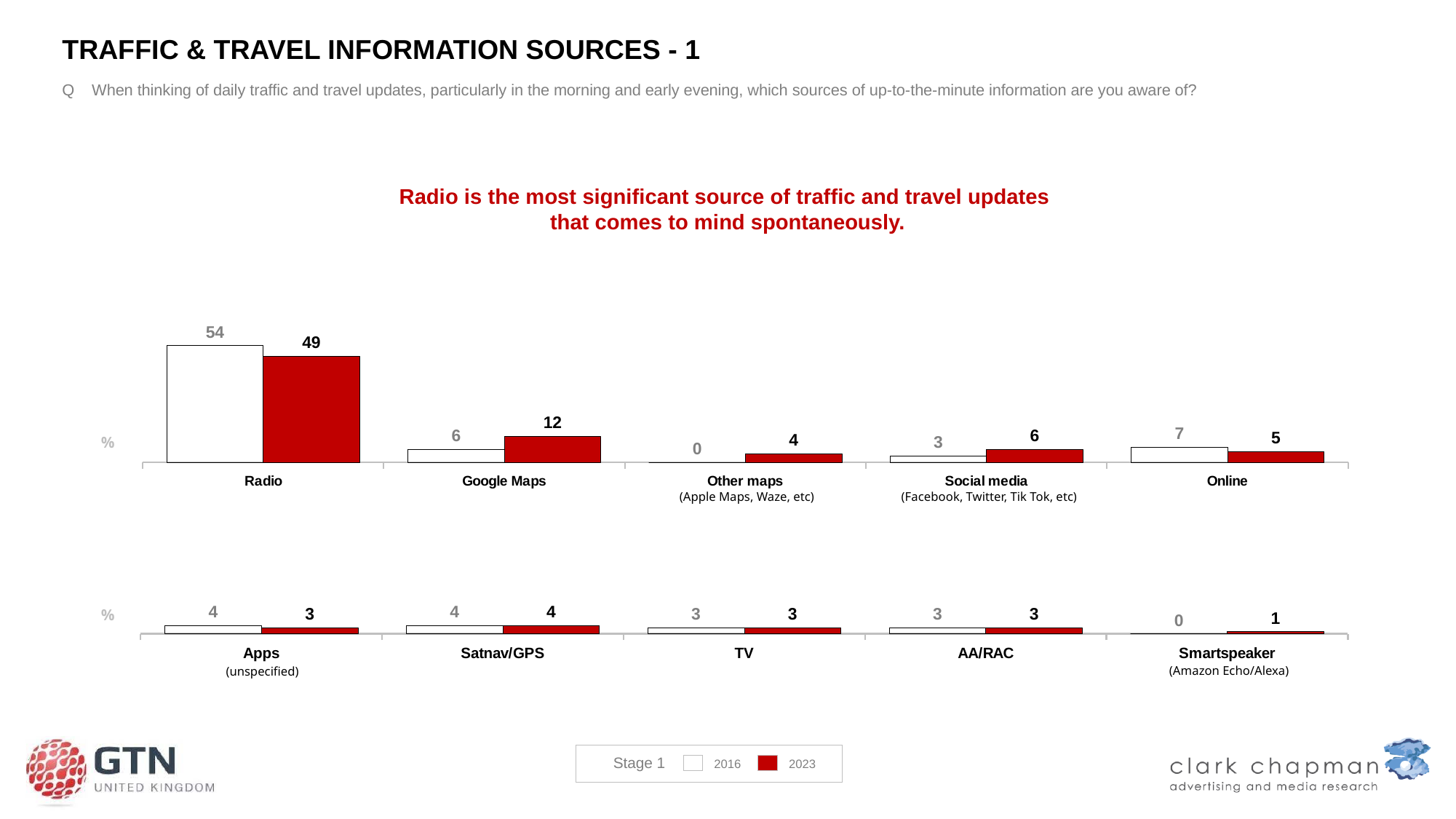
How many categories are shown in the bottom chart? 5 In the bottom chart, what is the 2016 value for Apps? 4 How many series does the legend list? 2 In the top chart, what is the difference between the 2016 and 2023 values for Radio? 5 In the top chart, what is the 2016 value for Google Maps? 6 In the bottom chart, what is the 2023 value for Smartspeaker? 1 In the top chart, which category has the highest 2023 value? Radio In the top chart, which is larger for Online: the 2016 value or the 2023 value? 2016 In the bottom chart, which category has the lowest 2016 value? Smartspeaker What type of chart is the top chart? Bar chart In the top chart, which category has the lowest 2016 value? Other maps In the top chart, what is the 2023 value for Radio? 49